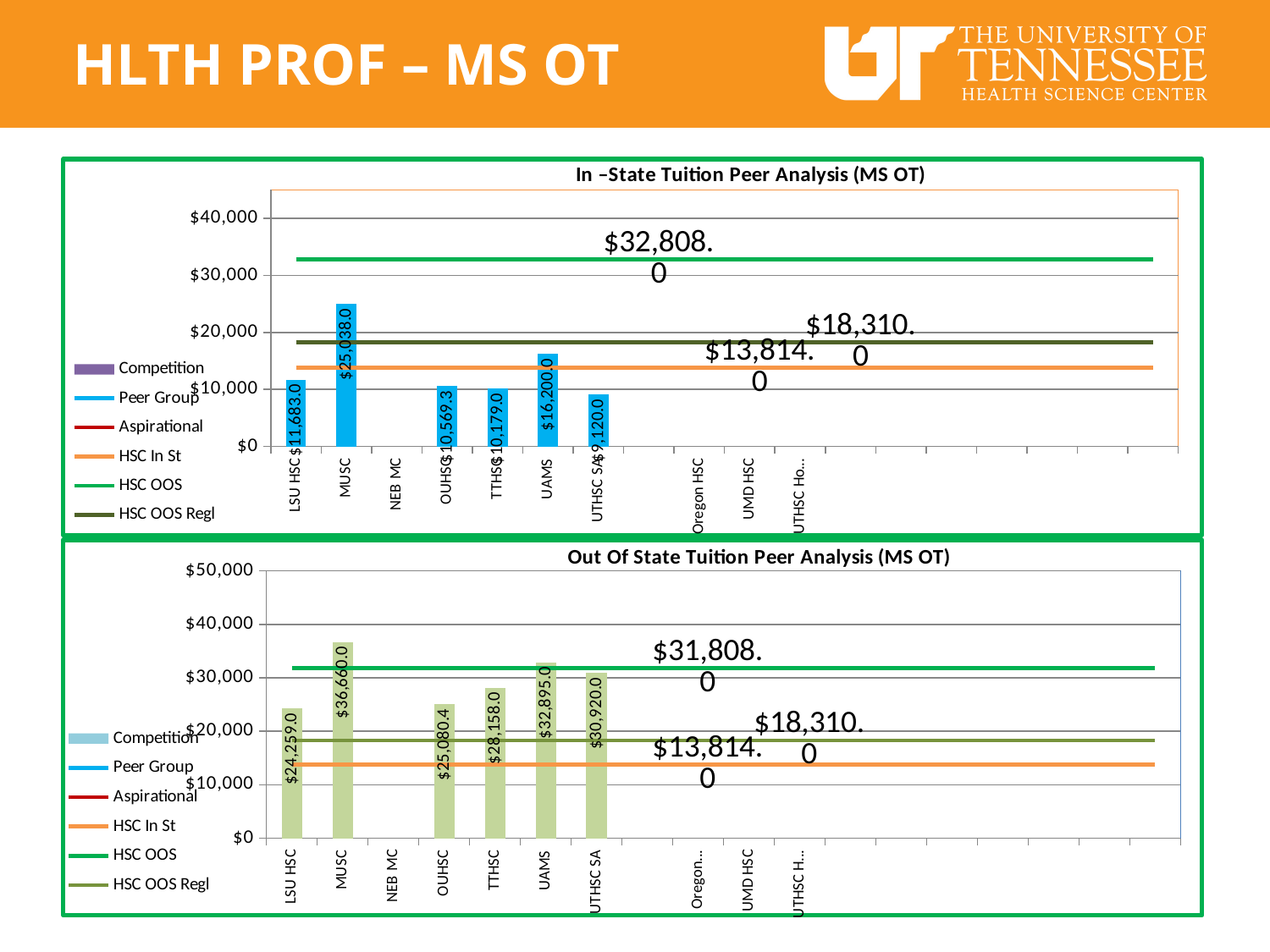
In the Out Of State Tuition Peer Analysis (MS OT) chart, what is the value for MUSC? $36,660.0 What kind of chart is the Out Of State Tuition Peer Analysis (MS OT) chart? bar chart In the In-State Tuition Peer Analysis (MS OT) chart, is the value for MUSC greater or less than $20,000? greater In the In-State Tuition Peer Analysis (MS OT) chart, which school has the lowest bar? UTHSC SA In the In-State Tuition Peer Analysis (MS OT) chart, what is the difference between the UAMS value and the LSU HSC value? $4,517.0 In the In-State Tuition Peer Analysis (MS OT) chart, what value is labelled on the HSC OOS line? $32,808.0 In the In-State Tuition Peer Analysis (MS OT) chart, what is the value for MUSC? $25,038.0 In the Out Of State Tuition Peer Analysis (MS OT) chart, which is larger, the value for UAMS or the value for UTHSC SA? UAMS How many entries does the legend of the In-State Tuition Peer Analysis (MS OT) chart list? 6 In the Out Of State Tuition Peer Analysis (MS OT) chart, which school has the highest bar? MUSC In the In-State Tuition Peer Analysis (MS OT) chart, which school has the highest bar? MUSC In the Out Of State Tuition Peer Analysis (MS OT) chart, what value is labelled on the HSC OOS Regl line? $18,310.0